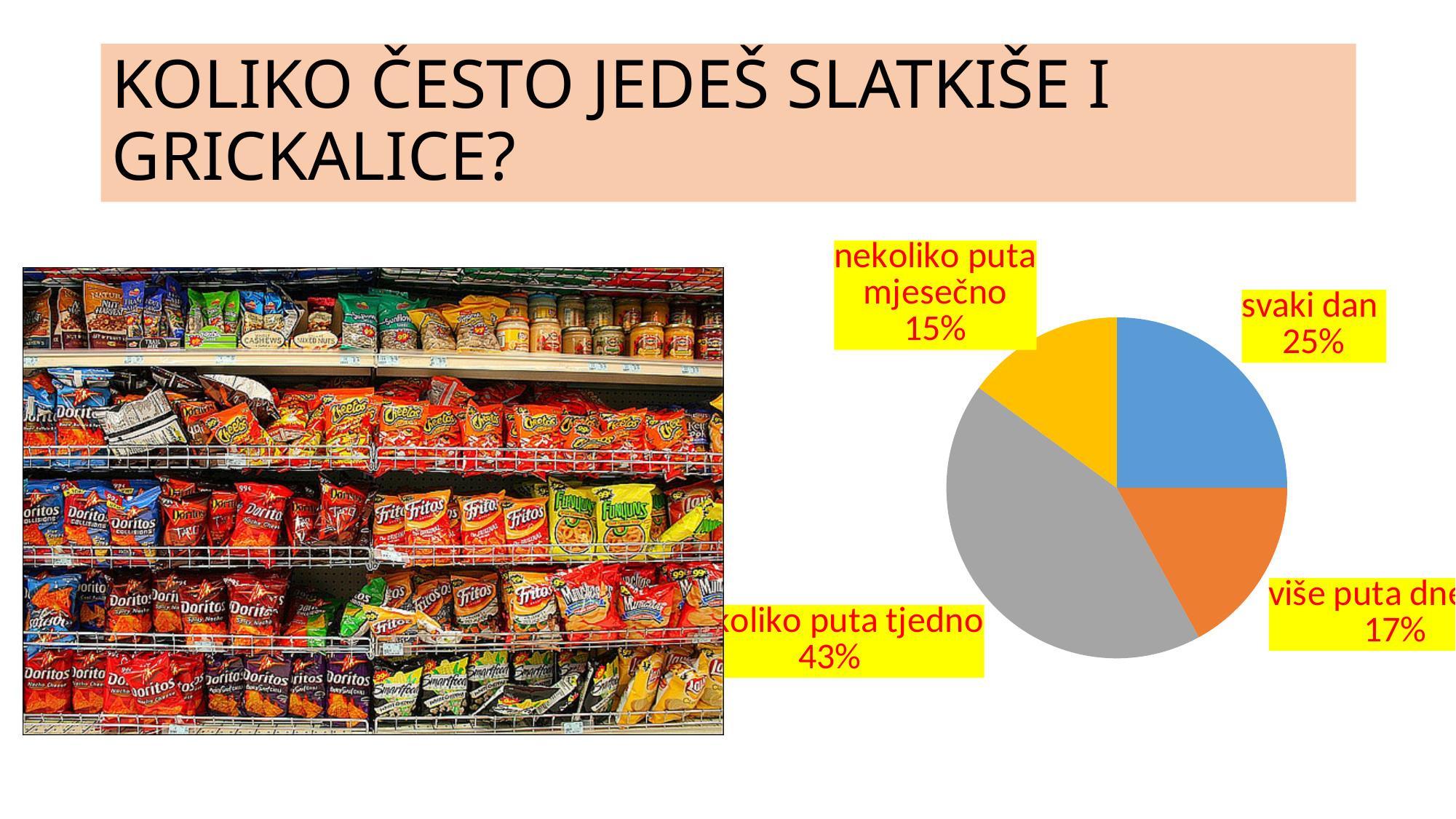
What percentage of the pie chart is labelled "nekoliko puta mjesečno"? 15% Which slice of the pie chart is the smallest? nekoliko puta mjesečno (15%) What is the title of the slide containing the pie chart? KOLIKO ČESTO JEDEŠ SLATKIŠE I GRICKALICE? What percentage is shown for the "više puta dnevno" slice of the pie chart? 17% How many percentage points larger is the "svaki dan" slice than the "nekoliko puta mjesečno" slice? 10% What is the combined share of the "svaki dan" and "više puta dnevno" slices? 42% What type of chart is shown on the slide? pie chart Which slice of the pie chart is the largest? nekoliko puta tjedno (43%) What colour is the "svaki dan" slice of the pie chart? blue What percentage of the pie chart is labelled "svaki dan"? 25% How many slices does the pie chart have? 4 Which is larger in the pie chart: "svaki dan" or "više puta dnevno"? svaki dan